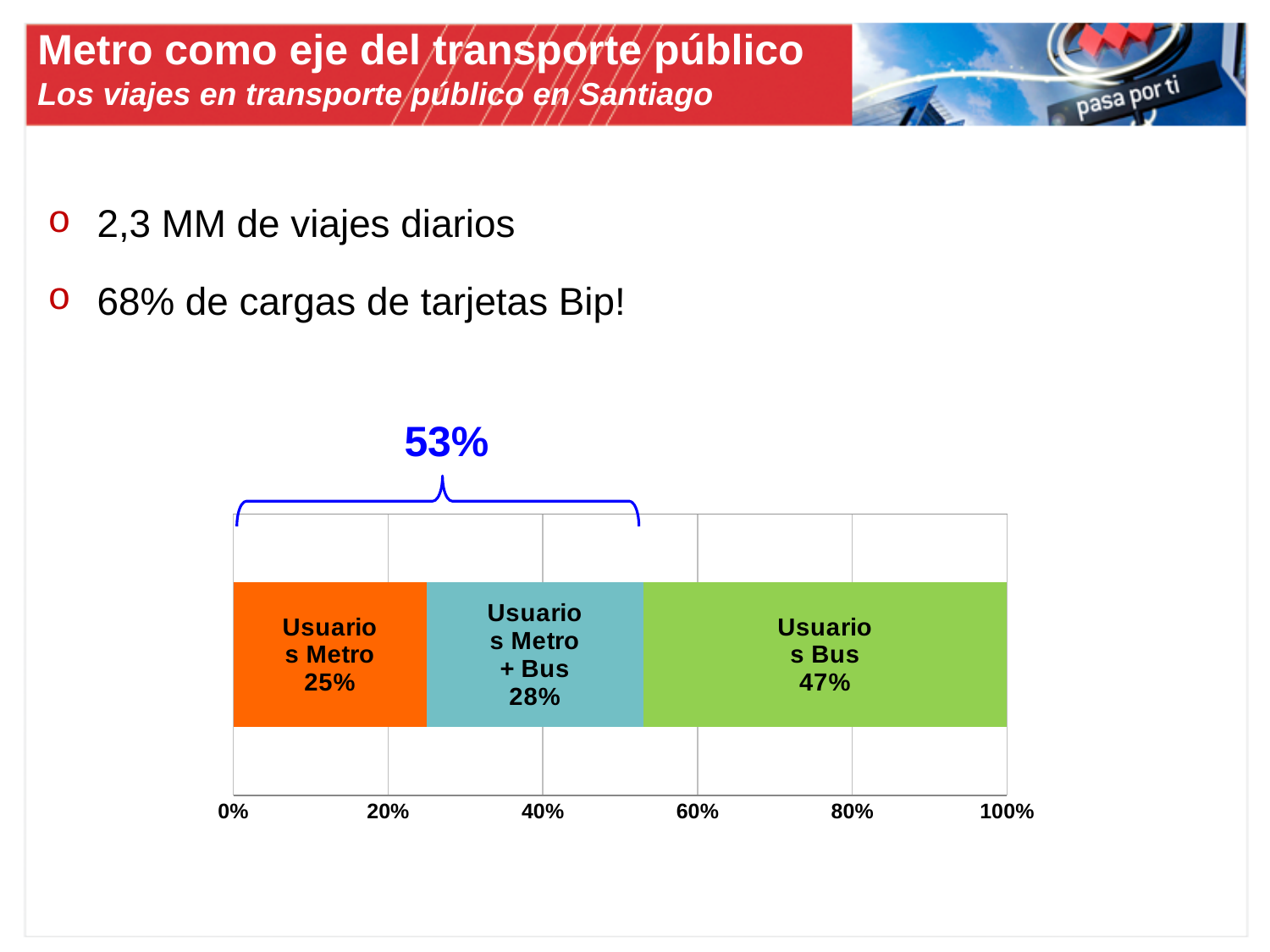
What percentage is shown for Usuarios Metro? 25% What is the highest value labelled on the horizontal axis? 100% What percentage is shown for Usuarios Metro + Bus? 28% Which segment of the bar has the largest share? Usuarios Bus Which segment of the bar has the smallest share? Usuarios Metro What kind of chart is shown on the slide? Stacked bar chart What is the combined share of Usuarios Metro and Usuarios Metro + Bus, as marked by the bracket above the bar? 53% What is the difference between the Usuarios Bus share and the Usuarios Metro share? 22% Which is larger, the share for Usuarios Metro + Bus or the share for Usuarios Metro? Usuarios Metro + Bus How many segments make up the stacked bar? 3 What percentage is shown for Usuarios Bus? 47% Is the value for Usuarios Bus greater or less than 40%? greater